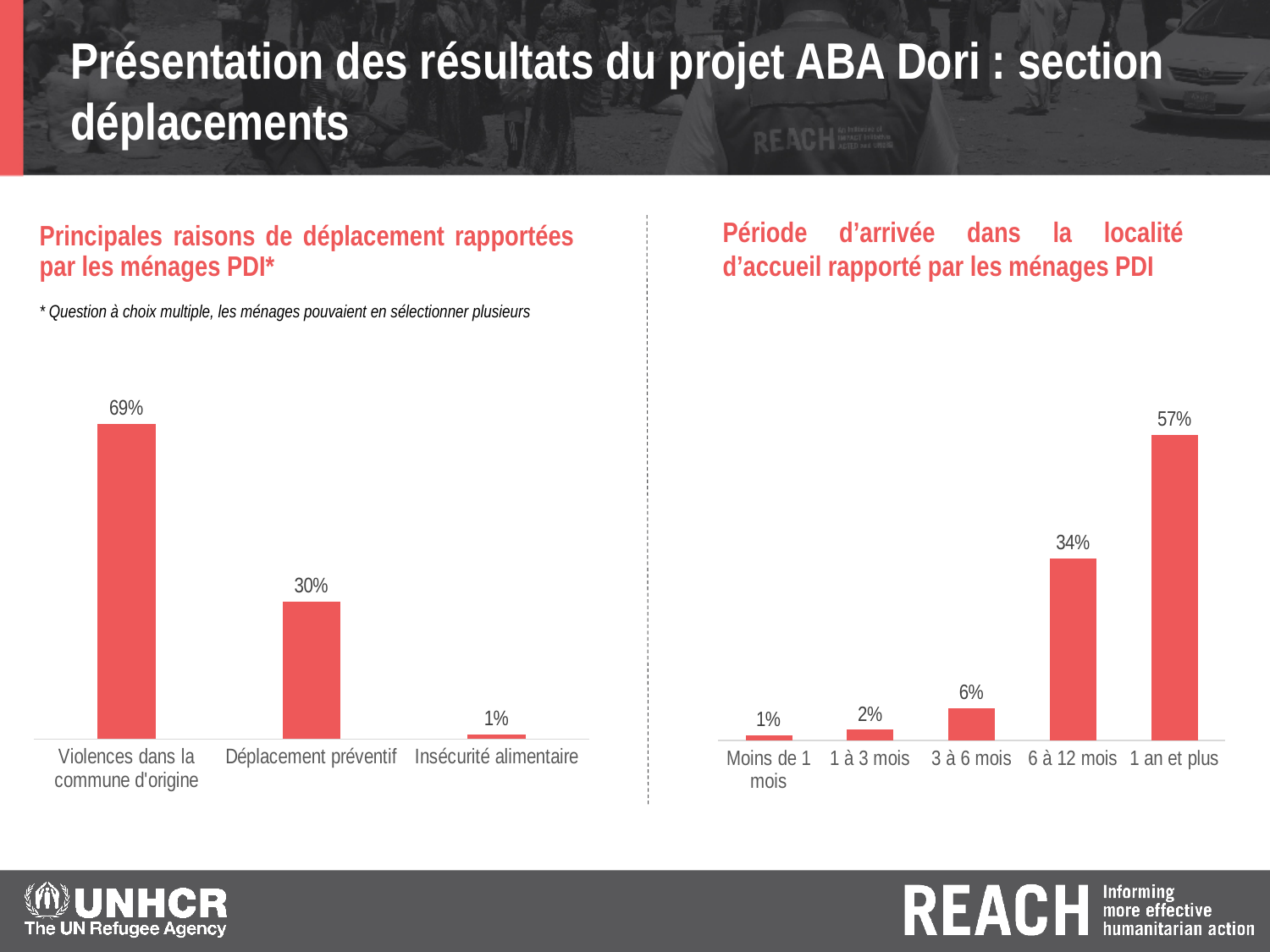
In the right chart (Période d'arrivée), which category has the highest value? 1 an et plus In the left chart (Principales raisons de déplacement), how many categories are shown? 3 In the left chart (Principales raisons de déplacement), which category has the lowest value? Insécurité alimentaire In the right chart (Période d'arrivée), which is larger: '1 à 3 mois' or '3 à 6 mois'? 3 à 6 mois In the right chart (Période d'arrivée), what is the value for '3 à 6 mois'? 6% What type of chart is the right chart (Période d'arrivée)? bar chart In the left chart (Principales raisons de déplacement), what is the difference between 'Violences dans la commune d'origine' and 'Déplacement préventif'? 39% In the right chart (Période d'arrivée), what is the difference between '1 an et plus' and '6 à 12 mois'? 23% In the right chart (Période d'arrivée), what is the value for '6 à 12 mois'? 34% In the right chart (Période d'arrivée), do the values rise or fall from left to right along the x axis? rise In the left chart (Principales raisons de déplacement), what is the value for 'Violences dans la commune d'origine'? 69% In the left chart (Principales raisons de déplacement), what is the value for 'Déplacement préventif'? 30%